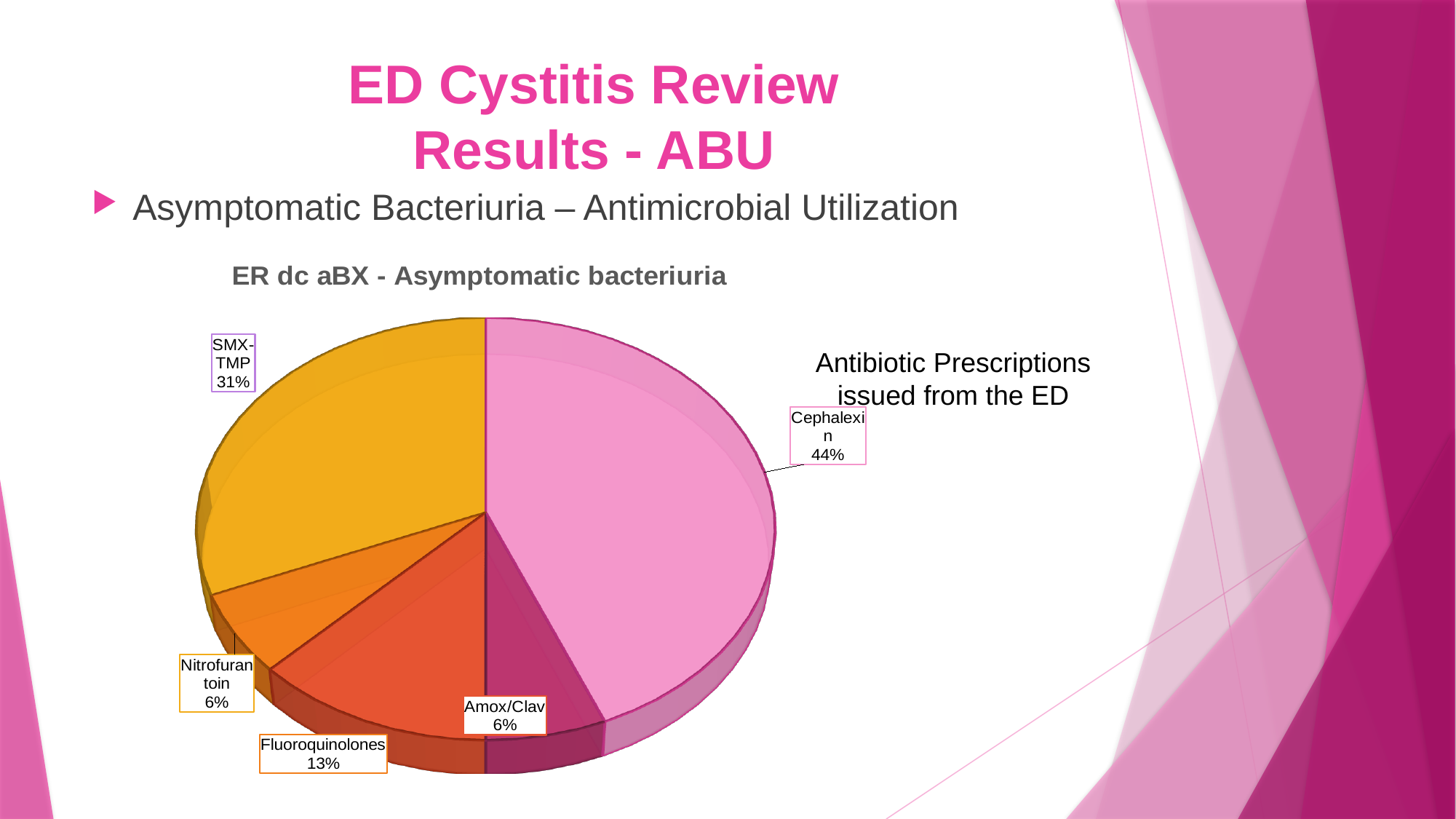
What is the title of the chart? ER dc aBX - Asymptomatic bacteriuria How many slices does the pie chart have? 5 What is the difference in percentage points between Cephalexin and SMX-TMP? 13 What percentage of the pie is Fluoroquinolones? 13% What percentage of the pie is Amox/Clav? 6% What type of chart is shown on the slide? Pie chart What percentage of the pie is Nitrofurantoin? 6% What is the combined share of Cephalexin and SMX-TMP? 75% Which has a larger share, SMX-TMP or Fluoroquinolones? SMX-TMP Which antibiotic has the largest share of the pie? Cephalexin What percentage of the pie is Cephalexin? 44% What percentage of the pie is SMX-TMP? 31%